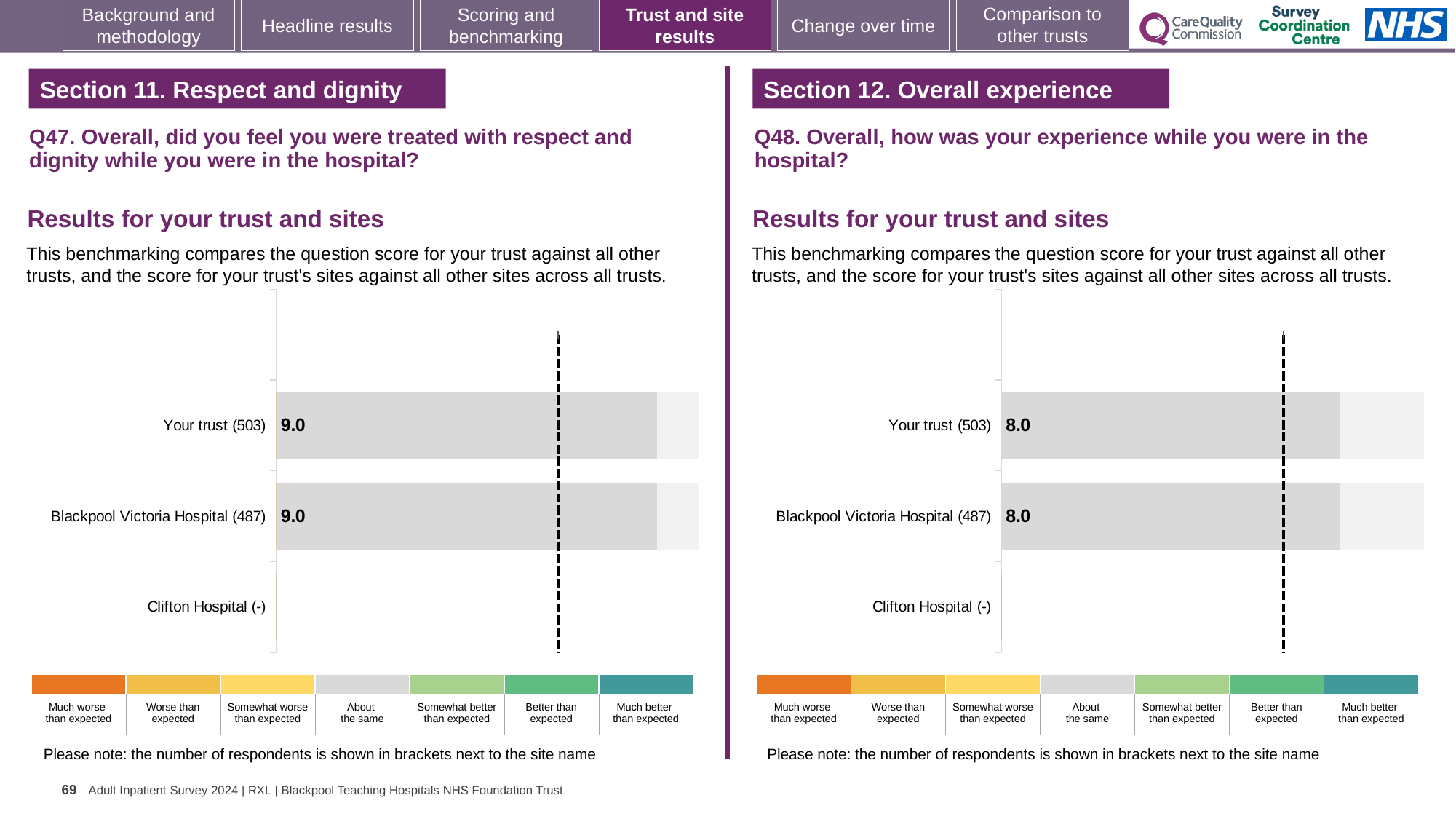
In the Q47 chart on the left, what is the score for Blackpool Victoria Hospital? 9.0 In the Q47 chart on the left, what is the score for Your trust? 9.0 In the Q48 chart on the right, how many respondents are shown in brackets for Your trust? 503 What kind of chart is used for the Q47 results on the left? Bar chart In the Q47 chart on the left, how many respondents are shown in brackets for Blackpool Victoria Hospital? 487 How many benchmark categories does the colour key below the Q48 chart on the right list? 7 In the Q48 chart on the right, what is the score for Your trust? 8.0 In the Q48 chart on the right, what is the score for Blackpool Victoria Hospital? 8.0 In the Q47 chart on the left, what is the difference between the score for Your trust and the score for Blackpool Victoria Hospital? 0.0 How many categories are listed on the y axis of the Q48 chart on the right? 3 In the Q48 chart on the right, what is the difference between the score for Your trust and the score for Blackpool Victoria Hospital? 0.0 How many categories are listed on the y axis of the Q47 chart on the left? 3